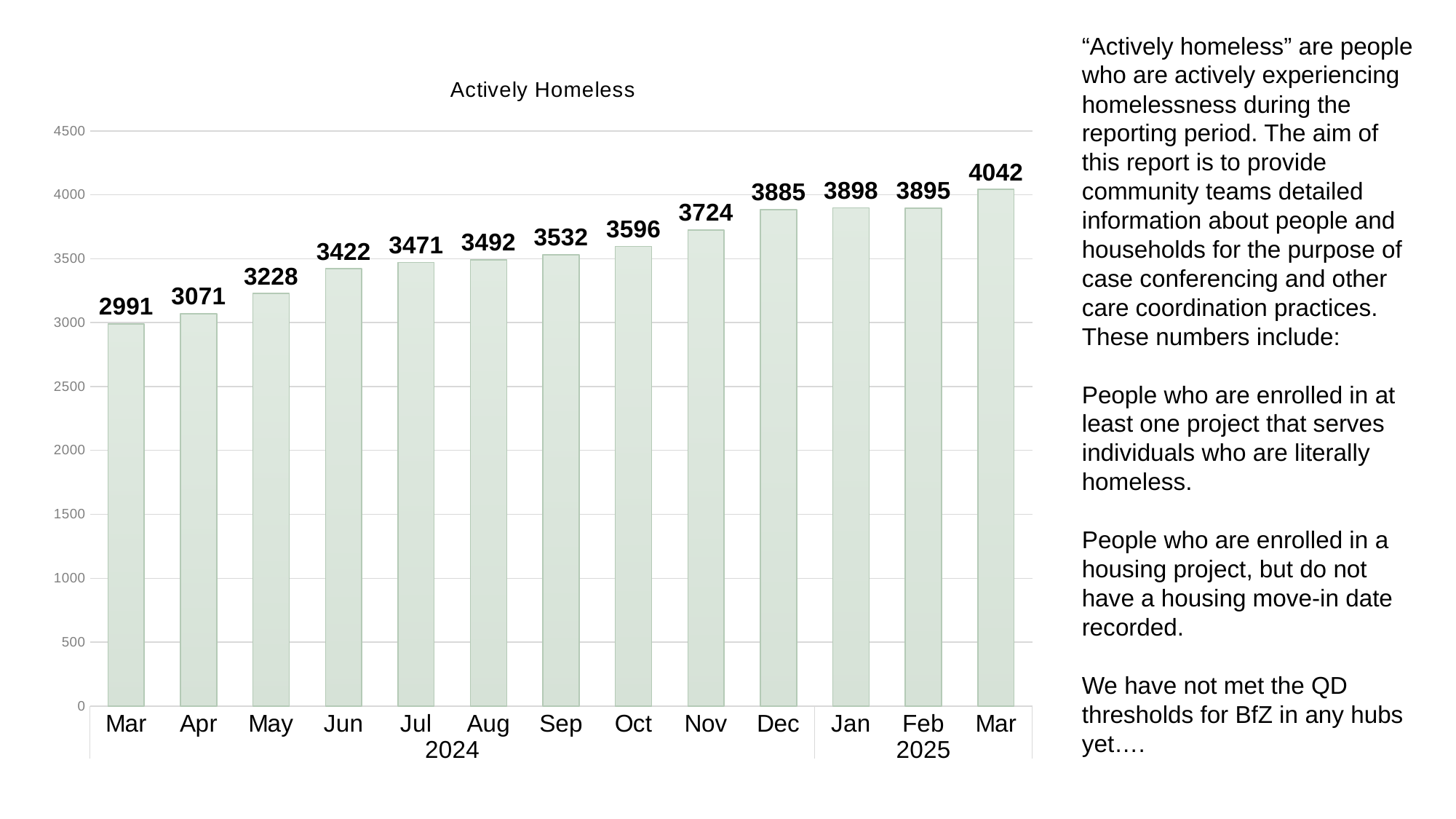
What is the difference between the values for Dec 2024 and Nov 2024? 161 What is the value for Nov 2024? 3724 Which month has the lowest value? Mar 2024 Do the values generally rise or fall from Mar 2024 to Mar 2025? rise Is the value for Oct 2024 greater or less than 3500? greater How many months are shown on the chart? 13 What is the value for Jan 2025? 3898 What is the value for Mar 2024? 2991 What is the difference between the values for Mar 2025 and Mar 2024? 1051 What kind of chart is this? bar chart Which month has the highest value? Mar 2025 Which is larger, the value for Jun 2024 or the value for Sep 2024? Sep 2024